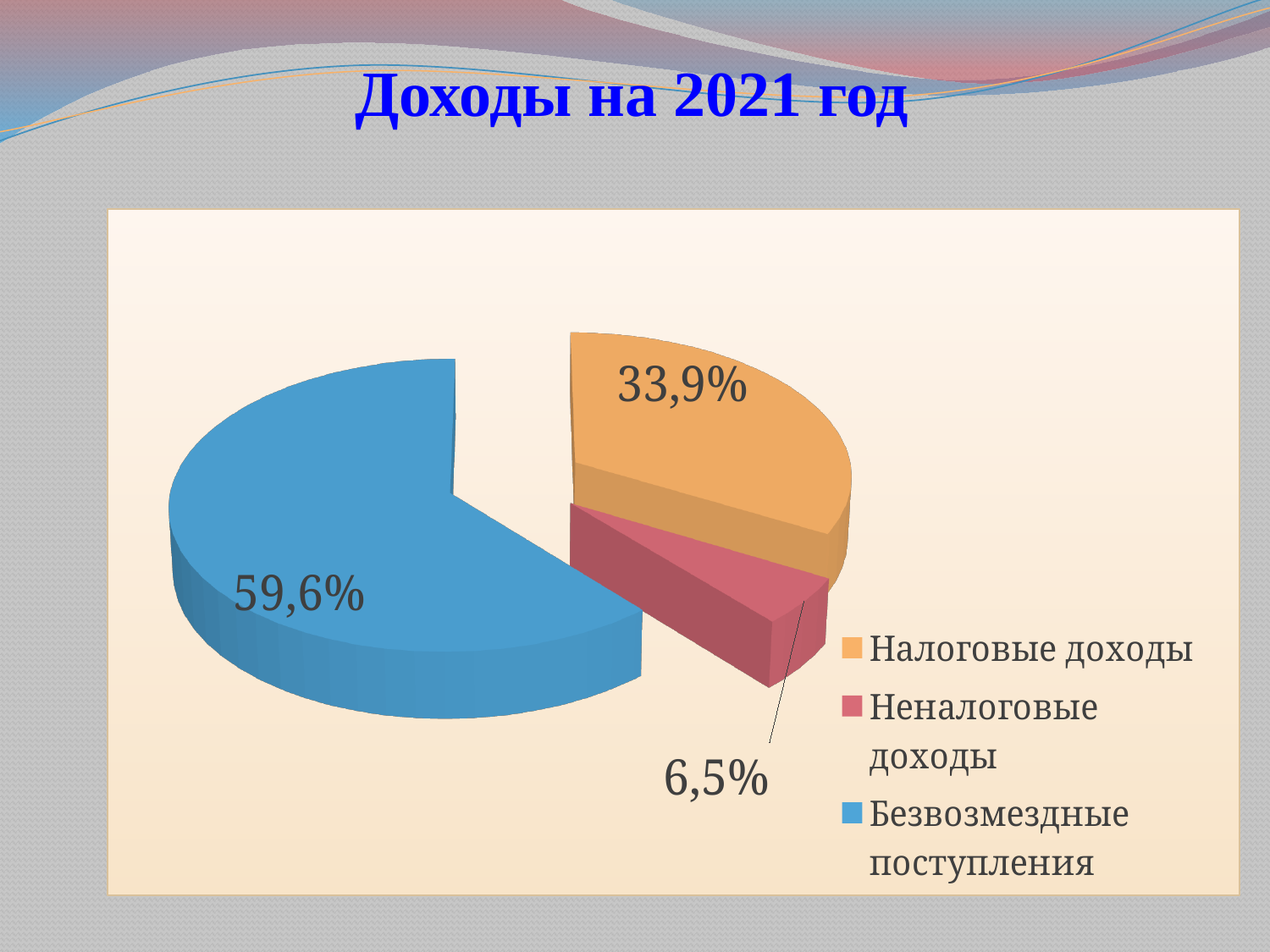
Which category has the smallest slice of the pie? Неналоговые доходы What is the difference in percentage points between Безвозмездные поступления and Налоговые доходы? 25,7 How many slices does the pie chart have? 3 Which is larger, the slice for Налоговые доходы or the slice for Неналоговые доходы? Налоговые доходы What colour is the slice for Безвозмездные поступления? Blue What is the difference in percentage points between Налоговые доходы and Неналоговые доходы? 27,4 What share of the pie is labelled for Неналоговые доходы? 6,5% Which category has the largest slice of the pie? Безвозмездные поступления What share of the pie is labelled for Безвозмездные поступления? 59,6% What kind of chart is shown on the slide? Pie chart What is the title of the slide? Доходы на 2021 год What share of the pie is labelled for Налоговые доходы? 33,9%